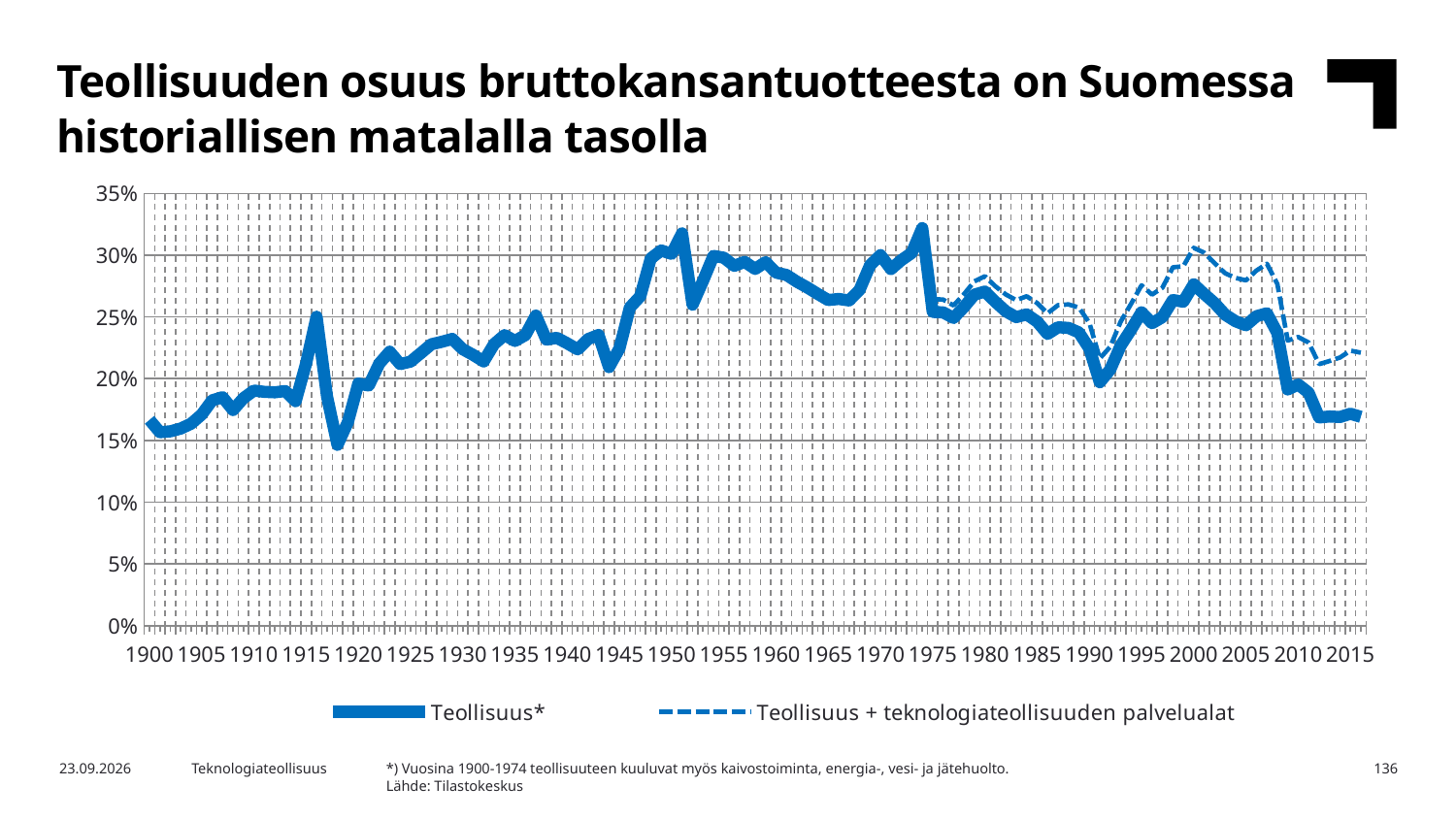
Which series is drawn with a dashed line? Teollisuus + teknologiateollisuuden palvelualat Is the Teollisuus* value in 1960 greater or less than 25%? greater How many series does the legend list? 2 Does the Teollisuus* series rise or fall between 1945 and 1950? rise Is the value of Teollisuus + teknologiateollisuuden palvelualat in 2015 greater or less than 20%? greater What kind of chart is shown on the slide? Line chart Does the Teollisuus* series rise or fall between 2005 and 2015? fall What is the title of the slide's chart? Teollisuuden osuus bruttokansantuotteesta on Suomessa historiallisen matalalla tasolla In 2010, which series has the higher value: Teollisuus* or Teollisuus + teknologiateollisuuden palvelualat? Teollisuus + teknologiateollisuuden palvelualat Is the Teollisuus* value in 1950 greater or less than 25%? greater